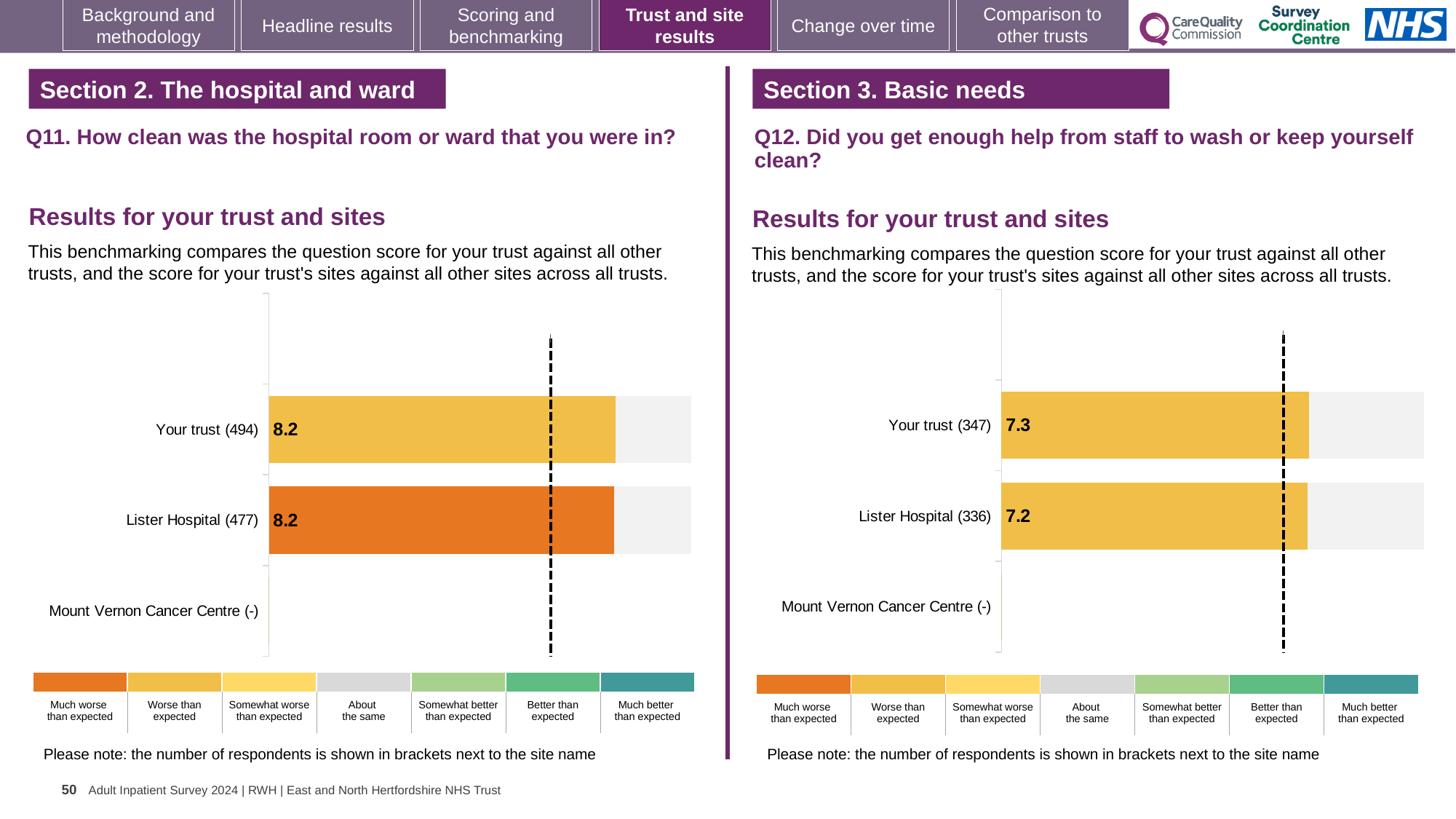
In the Q11 chart (left), what is the score for Your trust? 8.2 How many site/trust categories are listed on the y axis of the Q11 chart (left)? 3 In the Q12 chart (right), what is the score for Lister Hospital? 7.2 In the Q12 chart (right), which has the higher score, Your trust or Lister Hospital? Your trust In the Q11 chart (left), how many respondents are shown in brackets for Your trust? 494 What kind of chart is used in the Q12 chart (right)? Bar chart In the Q12 chart (right), how many respondents are shown in brackets for Lister Hospital? 336 In the Q12 chart (right), what is the score for Your trust? 7.3 In the Q12 chart (right), what is the difference between the Your trust score and the Lister Hospital score? 0.1 In the Q11 chart (left), which benchmark category does the colour of the Lister Hospital bar correspond to in the legend? Much worse than expected In the Q11 chart (left), what is the score for Lister Hospital? 8.2 How many benchmark categories does the legend below the Q12 chart (right) list? 7